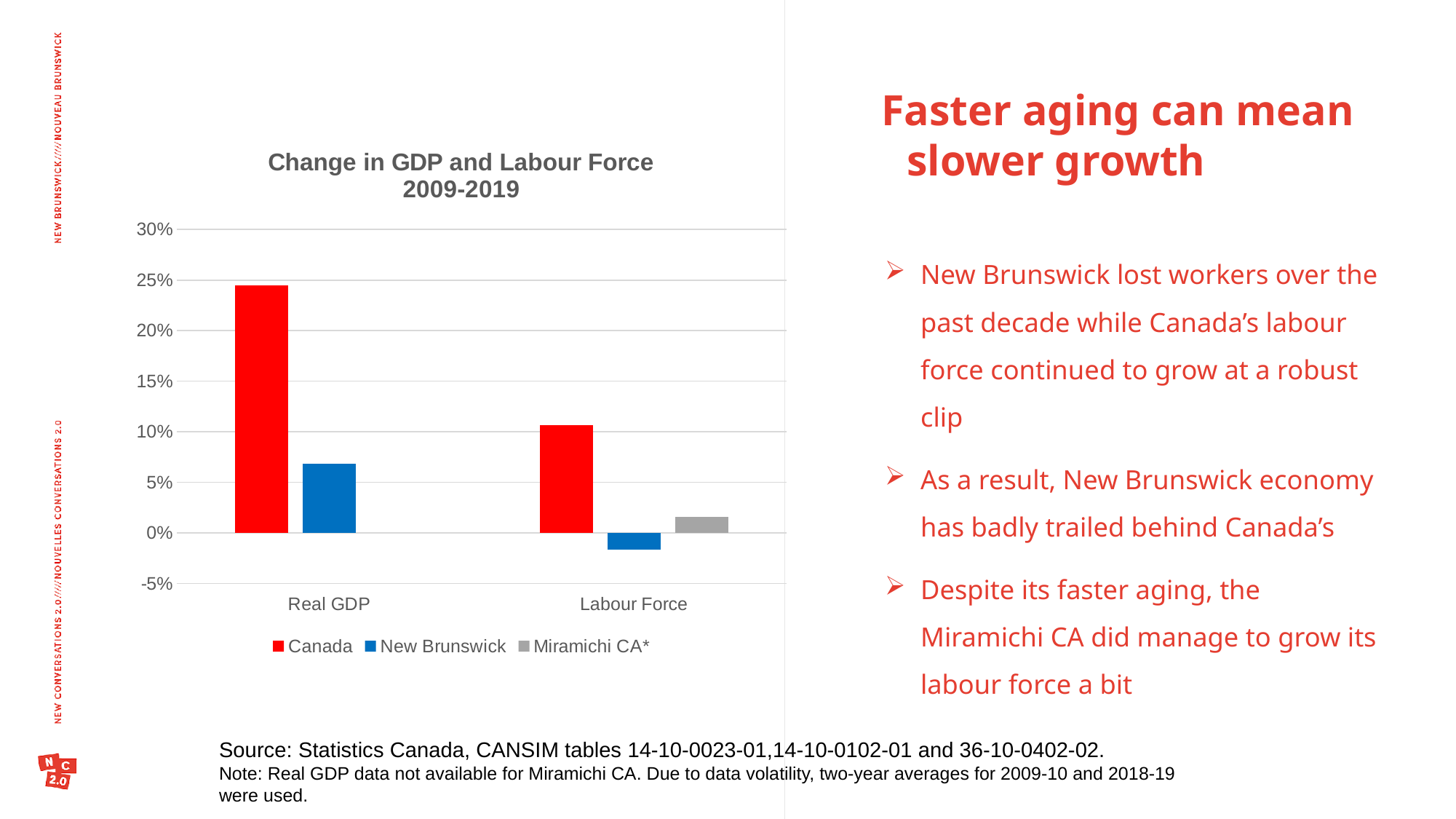
Which is larger for Labour Force: New Brunswick or Miramichi CA*? Miramichi CA* Which series has the lowest value for Labour Force? New Brunswick Is the value for New Brunswick's Real GDP greater or less than 10%? less Is the value for Canada's Labour Force greater or less than 10%? greater Which is larger: Canada's Real GDP change or Canada's Labour Force change? Real GDP Is the value for New Brunswick's Labour Force greater or less than 0%? less How many categories are shown on the x axis? 2 Which series has the highest value for Real GDP? Canada How many series does the legend list? 3 What kind of chart is shown on the slide? Bar chart What is the title of the chart? Change in GDP and Labour Force 2009-2019